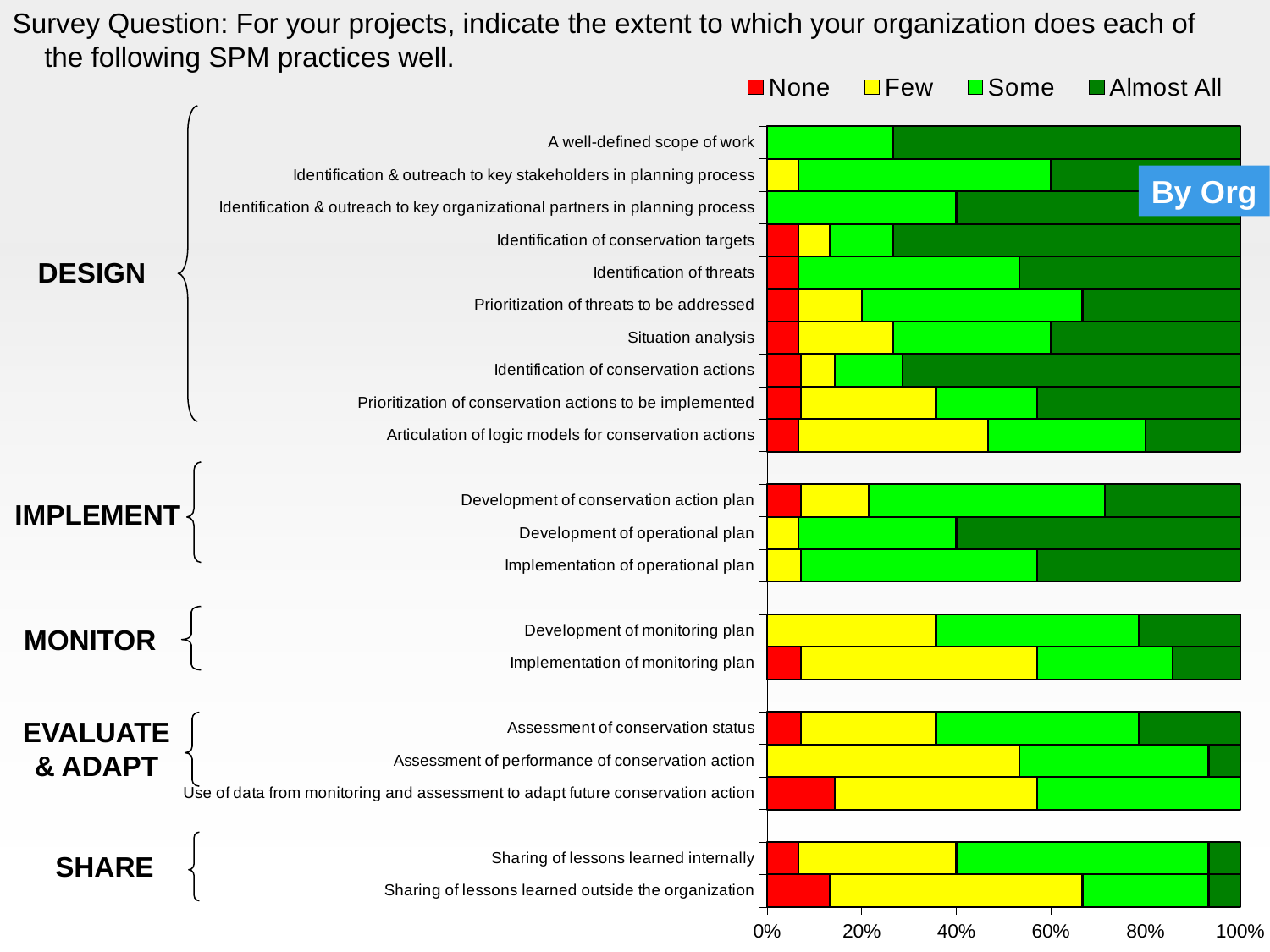
How many series does the legend list? 4 Which has a larger 'None' share: 'Use of data from monitoring and assessment to adapt future conservation action' or 'Identification of threats'? Use of data from monitoring and assessment to adapt future conservation action How many SPM practices (bars) are plotted in the chart? 20 Which has a larger 'Almost All' share: 'A well-defined scope of work' or 'Sharing of lessons learned outside the organization'? A well-defined scope of work Is the 'Almost All' share for 'A well-defined scope of work' greater or less than 60%? greater Is the 'Few' share for 'Development of monitoring plan' greater or less than 20%? greater What colour represents the 'None' series in the chart? Red What kind of chart is shown on the slide? Stacked bar chart Is the 'Almost All' share for 'Sharing of lessons learned internally' greater or less than 20%? less What are the four series listed in the legend? None, Few, Some, Almost All